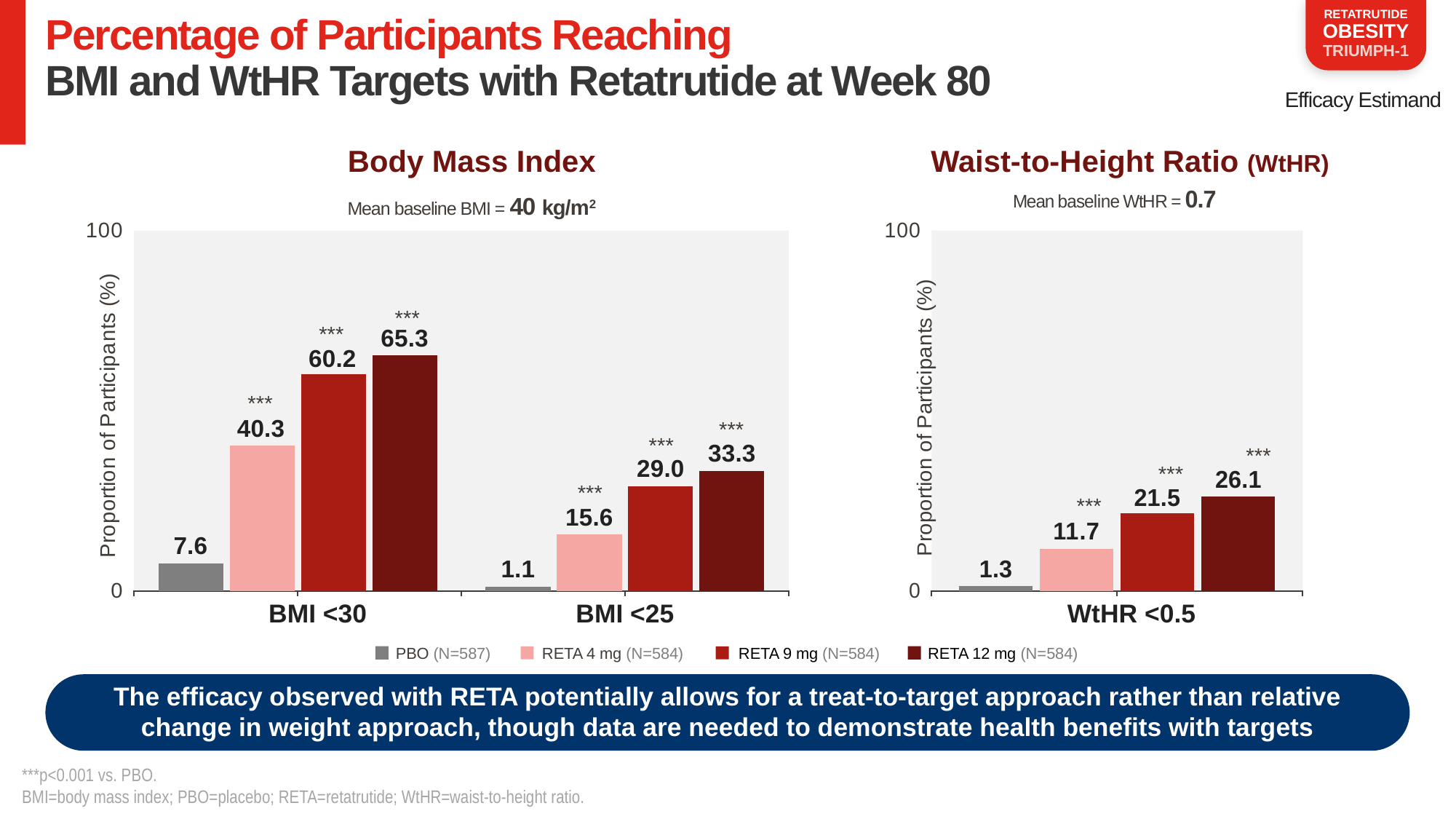
How many categories are shown on the x axis of the Body Mass Index chart? 2 In the Body Mass Index chart, what is the value for PBO in the BMI <25 category? 1.1 How many series does the legend list? 4 In the Body Mass Index chart, what is the difference between RETA 12 mg and RETA 9 mg in the BMI <30 category? 5.1 In the Body Mass Index chart, which is larger: RETA 4 mg for BMI <30 or RETA 12 mg for BMI <25? RETA 4 mg for BMI <30 What kind of chart is the Waist-to-Height Ratio chart? Bar chart In the Waist-to-Height Ratio chart, what is the value for RETA 9 mg? 21.5 In the Body Mass Index chart, which series has the lowest value in the BMI <30 category? PBO In the Waist-to-Height Ratio chart, what is the difference between RETA 4 mg and PBO? 10.4 What is the mean baseline BMI stated above the Body Mass Index chart? 40 kg/m² In the Waist-to-Height Ratio chart, which series has the highest value for WtHR <0.5? RETA 12 mg In the Body Mass Index chart, what is the value for RETA 12 mg in the BMI <30 category? 65.3